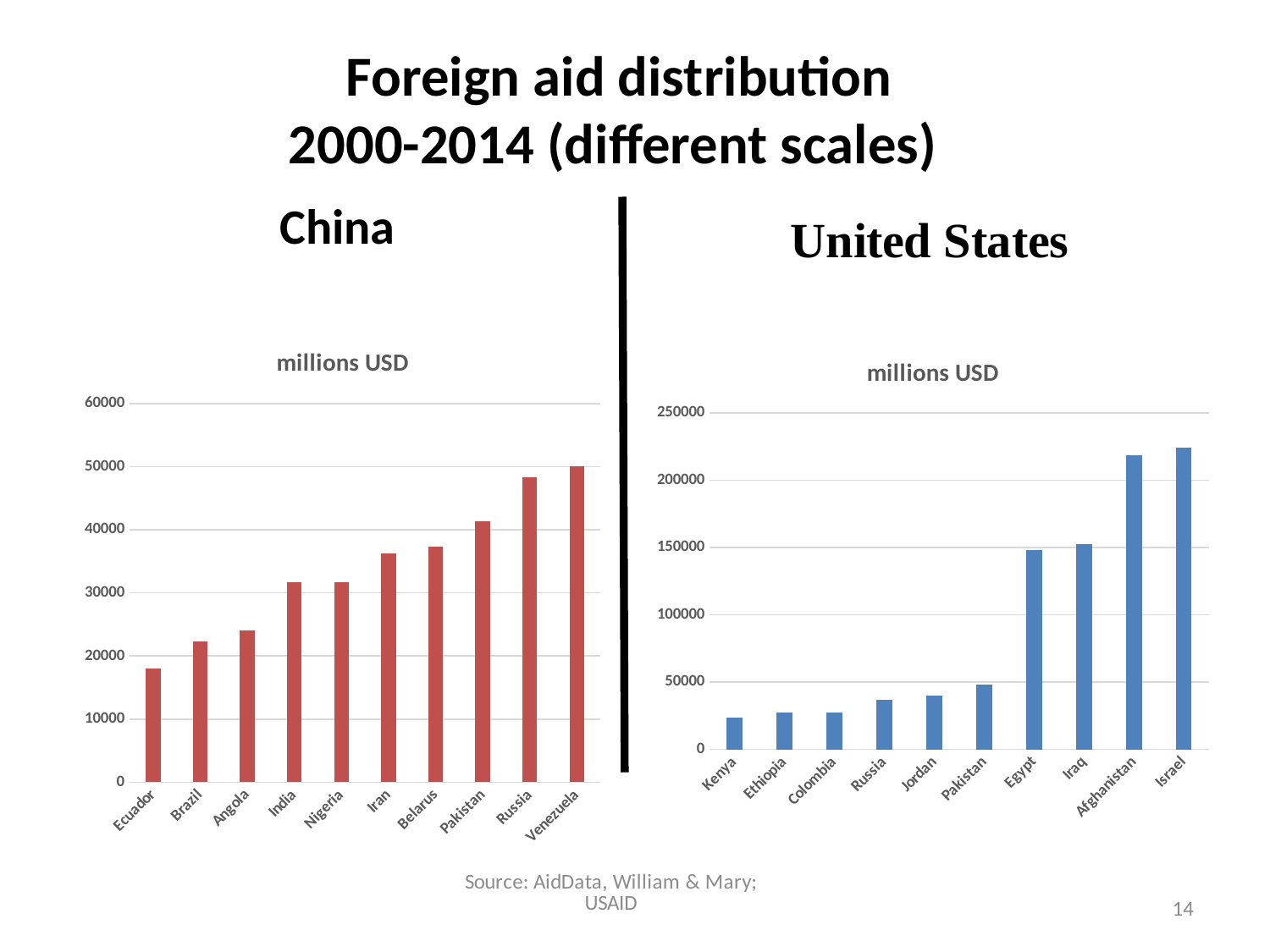
On the United States chart, which is larger, the value for Egypt or the value for Pakistan? Egypt On the China chart, which country has the lowest value? Ecuador What type of chart is the China chart? Bar chart On the China chart, is the value for Belarus greater or less than 40000? less On the China chart, which is larger, the value for Russia or the value for Ecuador? Russia On the China chart, which country has the highest value? Venezuela On the United States chart, which country has the lowest value? Kenya On the United States chart, which country has the highest value? Israel On the United States chart, is the value for Israel greater or less than 200000? greater On the China chart, is the value for Ecuador greater or less than 20000? less How many countries are shown on the United States chart? 10